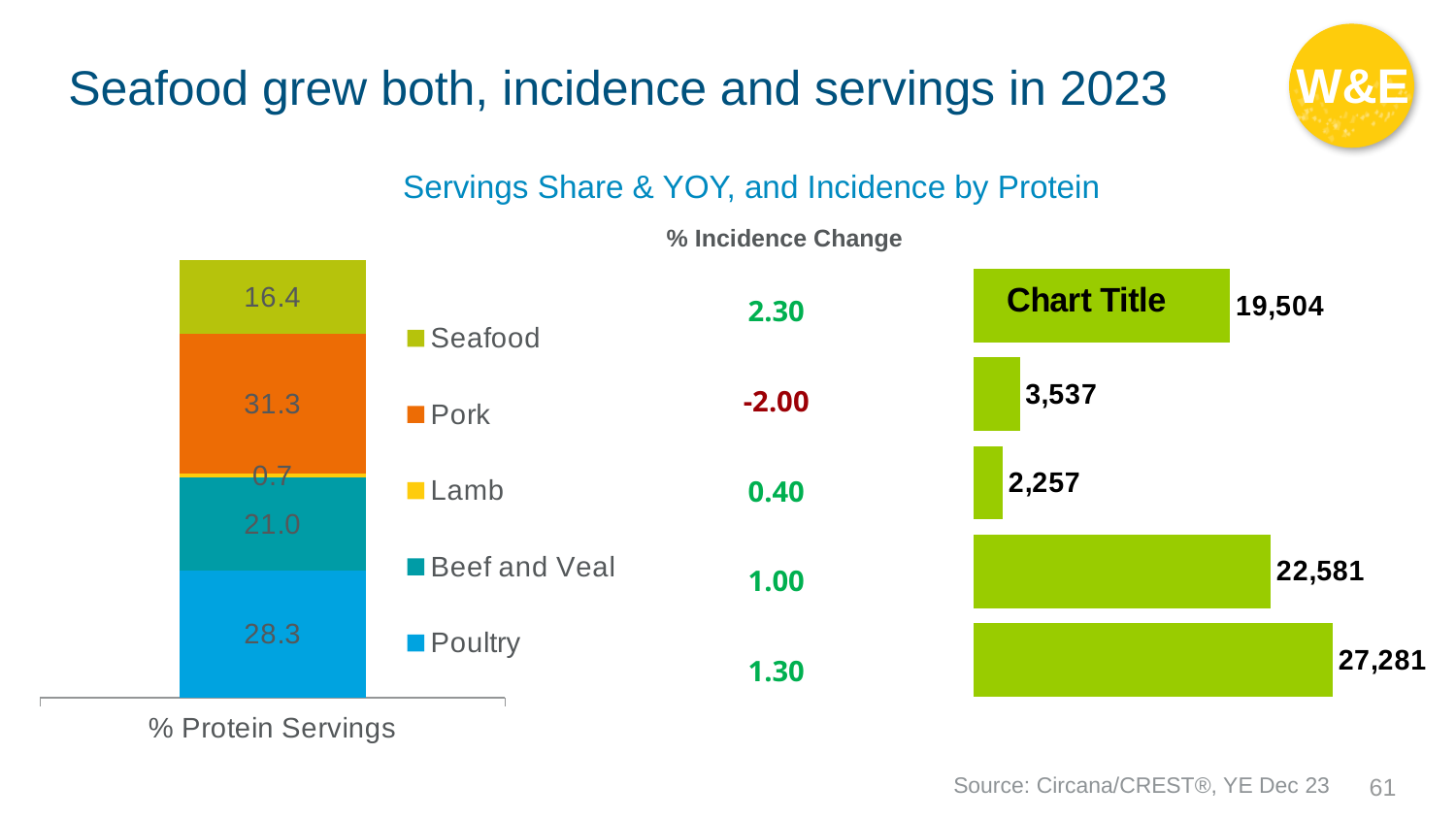
In the bar chart on the right titled "Chart Title", how many bars are shown? 5 In the stacked bar chart on the left (% Protein Servings), what is the value for Poultry? 28.3 In the stacked bar chart on the left (% Protein Servings), what is the value for Pork? 31.3 In the stacked bar chart on the left (% Protein Servings), which protein has the largest share? Pork In the bar chart on the right titled "Chart Title", what is the value of the bottom bar? 27,281 In the bar chart on the right titled "Chart Title", what is the value of the top bar? 19,504 How many series does the legend of the stacked bar chart on the left list? 5 In the stacked bar chart on the left (% Protein Servings), what is the value for Seafood? 16.4 In the stacked bar chart on the left (% Protein Servings), which protein has the smallest share? Lamb In the stacked bar chart on the left (% Protein Servings), what is the difference between the Pork and Poultry values? 3.0 What kind of chart is the chart on the right of the slide titled "Chart Title"? Bar chart In the stacked bar chart on the left (% Protein Servings), which is larger, Beef and Veal or Seafood? Beef and Veal